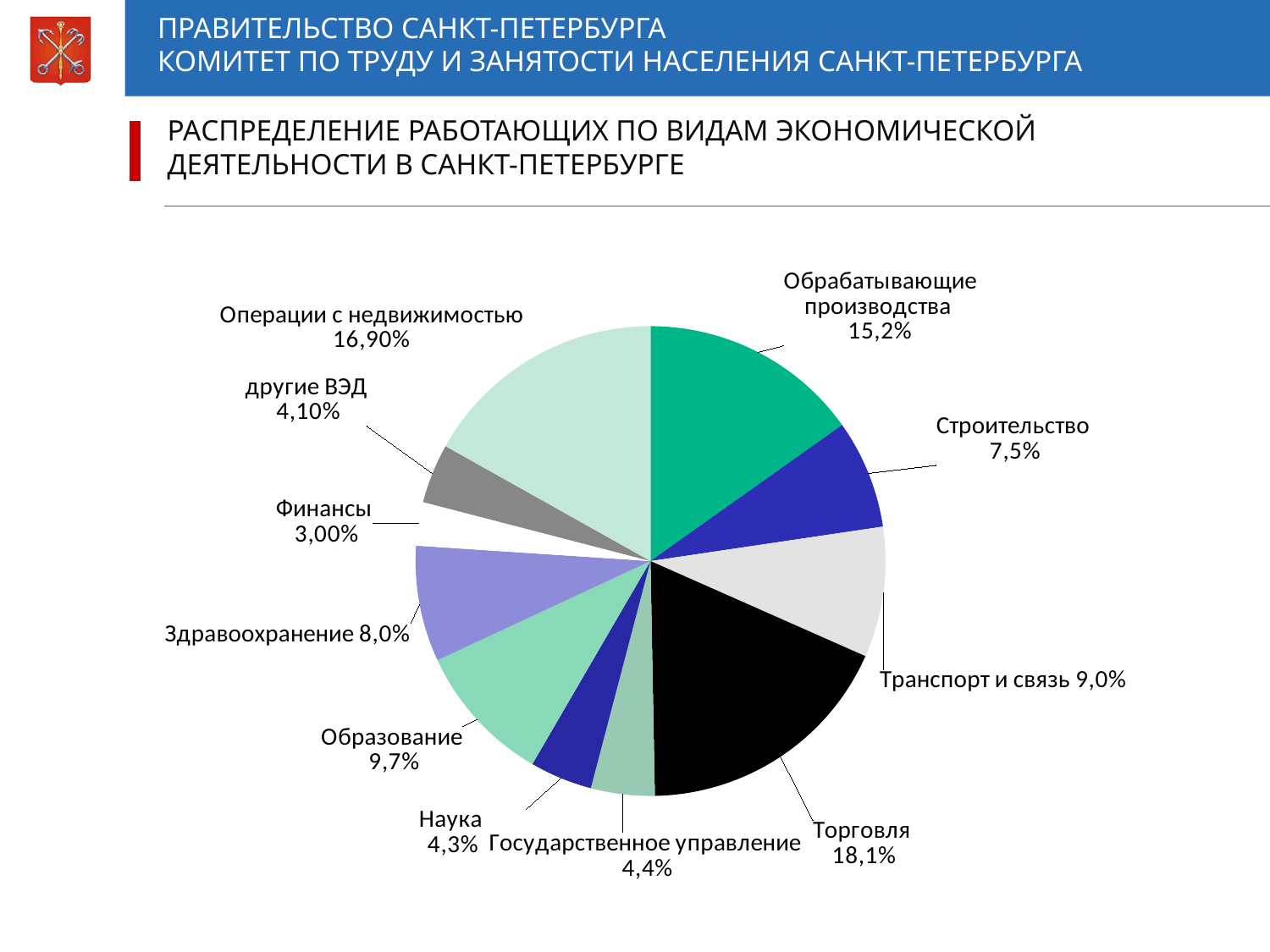
Which is larger, the share for Строительство or for Здравоохранение? Здравоохранение What share of workers is in Торговля? 18,1% What is the difference between the shares of Торговля and Обрабатывающие производства? 2,9 percentage points What is the value shown for Операции с недвижимостью? 16,90% Which category has the largest slice of the pie? Торговля What kind of chart is shown on the slide? pie chart What is the title of the chart on the slide? РАСПРЕДЕЛЕНИЕ РАБОТАЮЩИХ ПО ВИДАМ ЭКОНОМИЧЕСКОЙ ДЕЯТЕЛЬНОСТИ В САНКТ-ПЕТЕРБУРГЕ What is the difference between the shares of Образование and Здравоохранение? 1,7 percentage points How many categories are shown in the pie chart? 11 What is the value for Транспорт и связь? 9,0% What percentage is shown for Государственное управление? 4,4% Which category has the smallest slice of the pie? Финансы